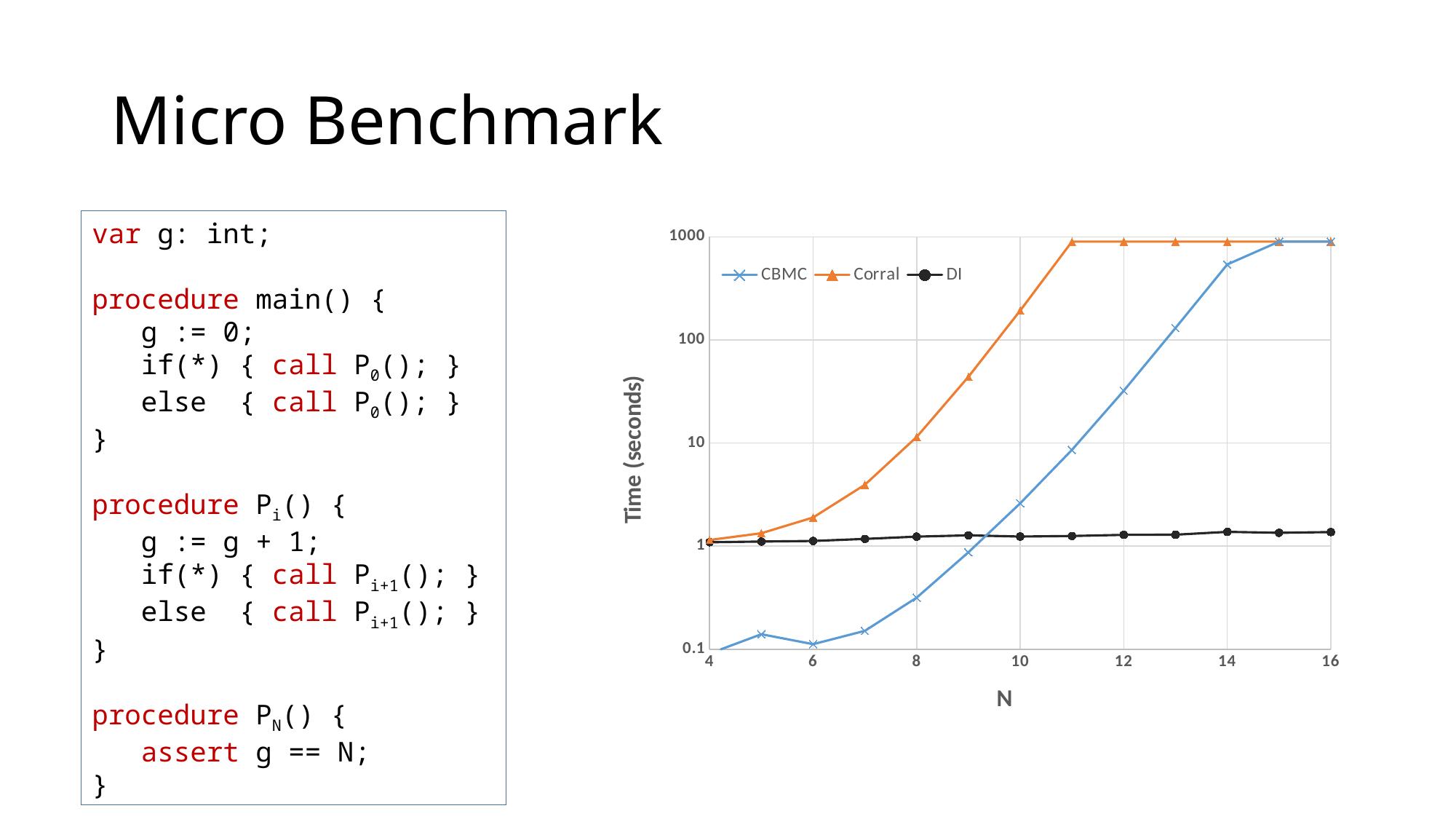
Which series has the highest time at N = 8? Corral What kind of chart is shown on the slide? Line chart Which series has the lowest time at N = 16? DI What are the series names listed in the chart's legend? CBMC, Corral, DI Is the DI value at N = 16 greater or less than 10? less Does the Corral series rise or fall as N increases from 4 to 11? Rise Is the Corral value at N = 10 greater or less than 100? greater Is the CBMC value at N = 8 greater or less than 1? less At N = 6, which series has the higher time, CBMC or DI? DI At N = 12, which series has the higher time, CBMC or Corral? Corral What is the label of the chart's vertical axis? Time (seconds) How many series does the chart's legend list? 3